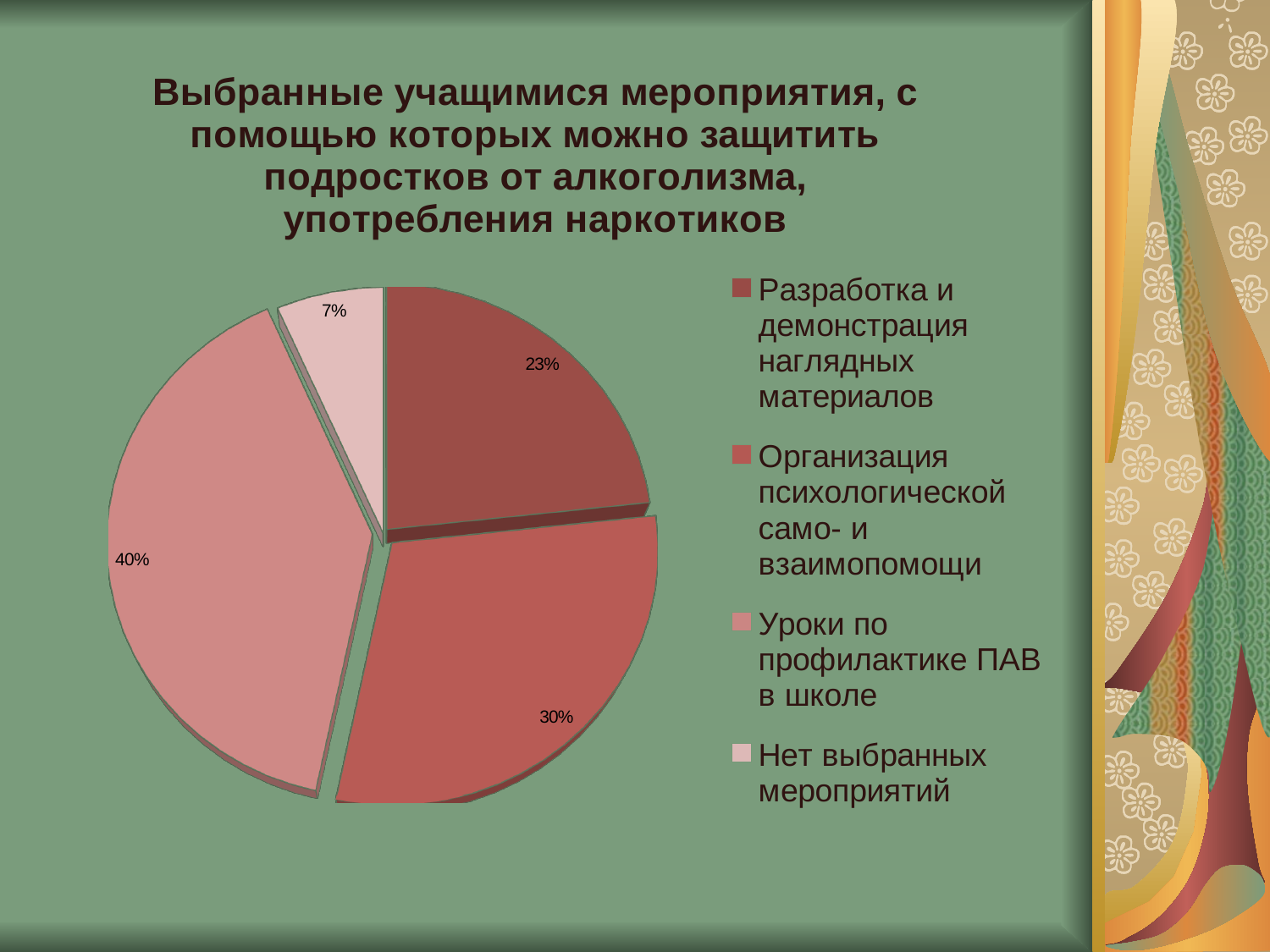
Which is larger: the slice for "Разработка и демонстрация наглядных материалов" or the slice for "Организация психологической само- и взаимопомощи"? Организация психологической само- и взаимопомощи Which category has the smallest slice of the pie? Нет выбранных мероприятий What share of the pie does "Нет выбранных мероприятий" have? 7% What kind of chart is shown on the slide? pie chart How many slices does the pie chart have? 4 What is the difference in percentage points between "Разработка и демонстрация наглядных материалов" and "Нет выбранных мероприятий"? 16 How many entries does the legend list? 4 What share of the pie does "Организация психологической само- и взаимопомощи" have? 30% What share of the pie does "Уроки по профилактике ПАВ в школе" have? 40% What is the difference in percentage points between "Уроки по профилактике ПАВ в школе" and "Организация психологической само- и взаимопомощи"? 10 Which category has the largest slice of the pie? Уроки по профилактике ПАВ в школе